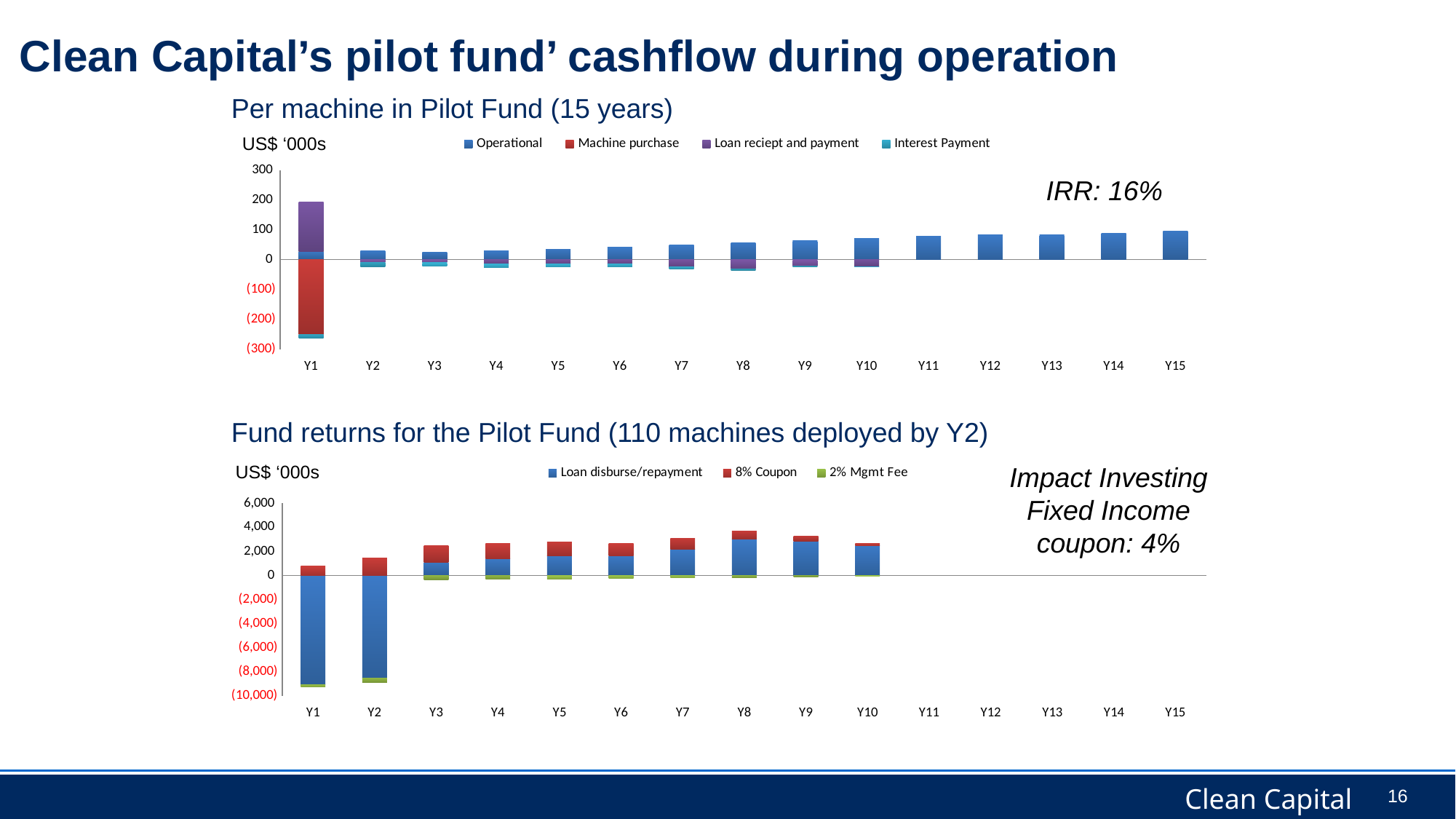
In the bottom chart, 'Fund returns for the Pilot Fund', is the Loan disburse/repayment value for Y1 greater or less than (8,000)? less In the top chart, 'Per machine in Pilot Fund (15 years)', does the Operational value rise or fall from Y2 to Y15? Rise In the bottom chart, 'Fund returns for the Pilot Fund', is the positive stacked bar for Y8 taller than the positive stacked bar for Y3? Yes, Y8 What IRR is stated on the top chart, 'Per machine in Pilot Fund (15 years)'? IRR: 16% How many series does the legend of the top chart, 'Per machine in Pilot Fund (15 years)', list? 4 What unit is shown on the y axis of the bottom chart, 'Fund returns for the Pilot Fund'? US$ '000s What kind of chart is the bottom chart, 'Fund returns for the Pilot Fund (110 machines deployed by Y2)'? Stacked bar chart What kind of chart is the top chart, 'Per machine in Pilot Fund (15 years)'? Stacked bar chart How many series does the legend of the bottom chart, 'Fund returns for the Pilot Fund', list? 3 How many year categories are shown on the x axis of the top chart, 'Per machine in Pilot Fund (15 years)'? 15 In the top chart, 'Per machine in Pilot Fund (15 years)', which year has the largest negative bar? Y1